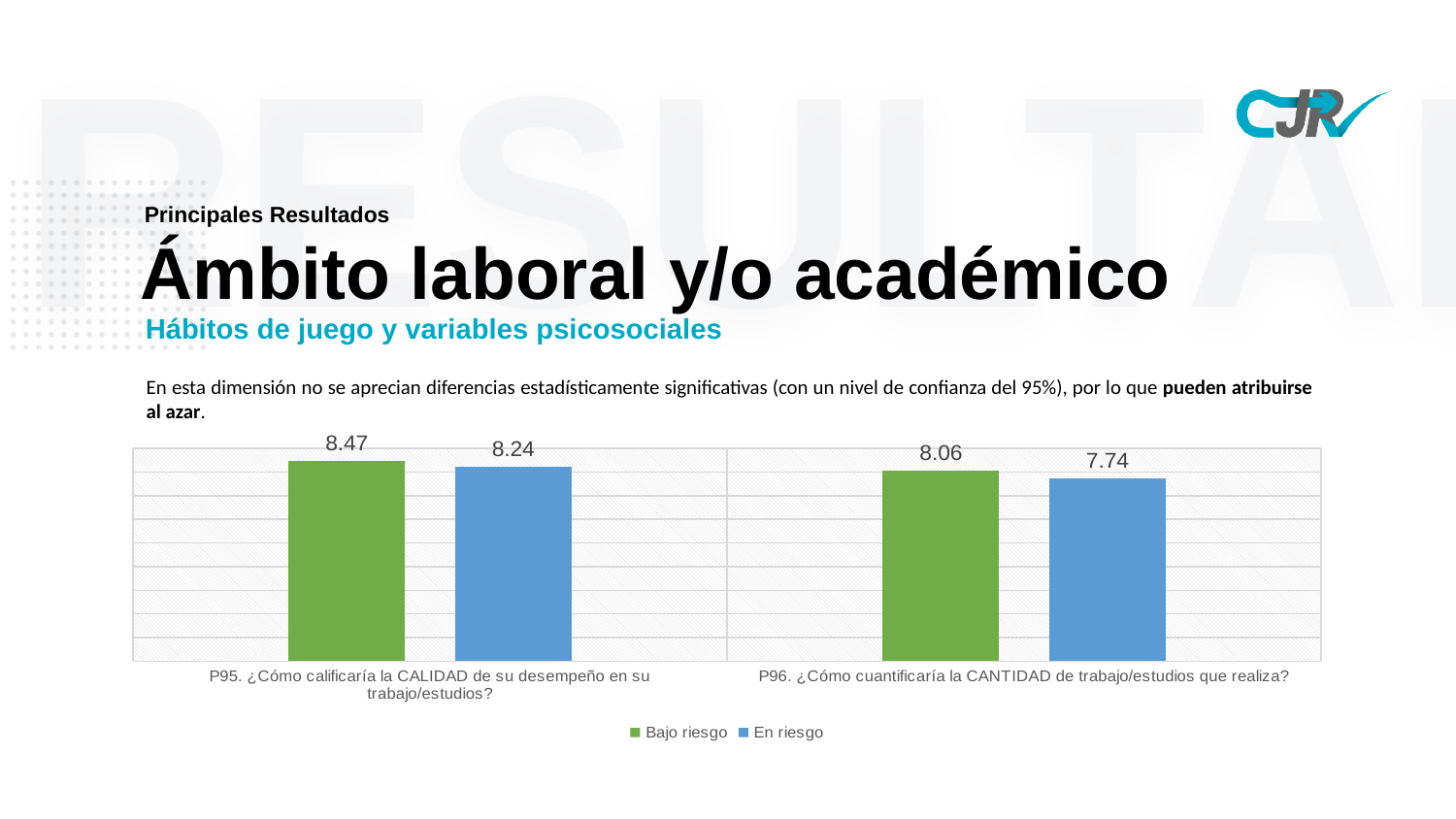
What is the value for En riesgo in the category P95 (CALIDAD de su desempeño en su trabajo/estudios)? 8.24 How many series does the legend list? 2 In category P96, which series has the larger value, Bajo riesgo or En riesgo? Bajo riesgo Which bar has the lowest value on the chart? En riesgo in P96 (7.74) How many categories are shown on the x axis of the chart? 2 What is the difference between the Bajo riesgo and En riesgo values in category P96? 0.32 Which bar has the highest value on the chart? Bajo riesgo in P95 (8.47) What kind of chart is shown on the slide? Bar chart What is the value for En riesgo in the category P96 (CANTIDAD de trabajo/estudios que realiza)? 7.74 What is the value for Bajo riesgo in the category P96 (CANTIDAD de trabajo/estudios que realiza)? 8.06 What is the difference between the Bajo riesgo and En riesgo values in category P95? 0.23 What is the value for Bajo riesgo in the category P95 (CALIDAD de su desempeño en su trabajo/estudios)? 8.47